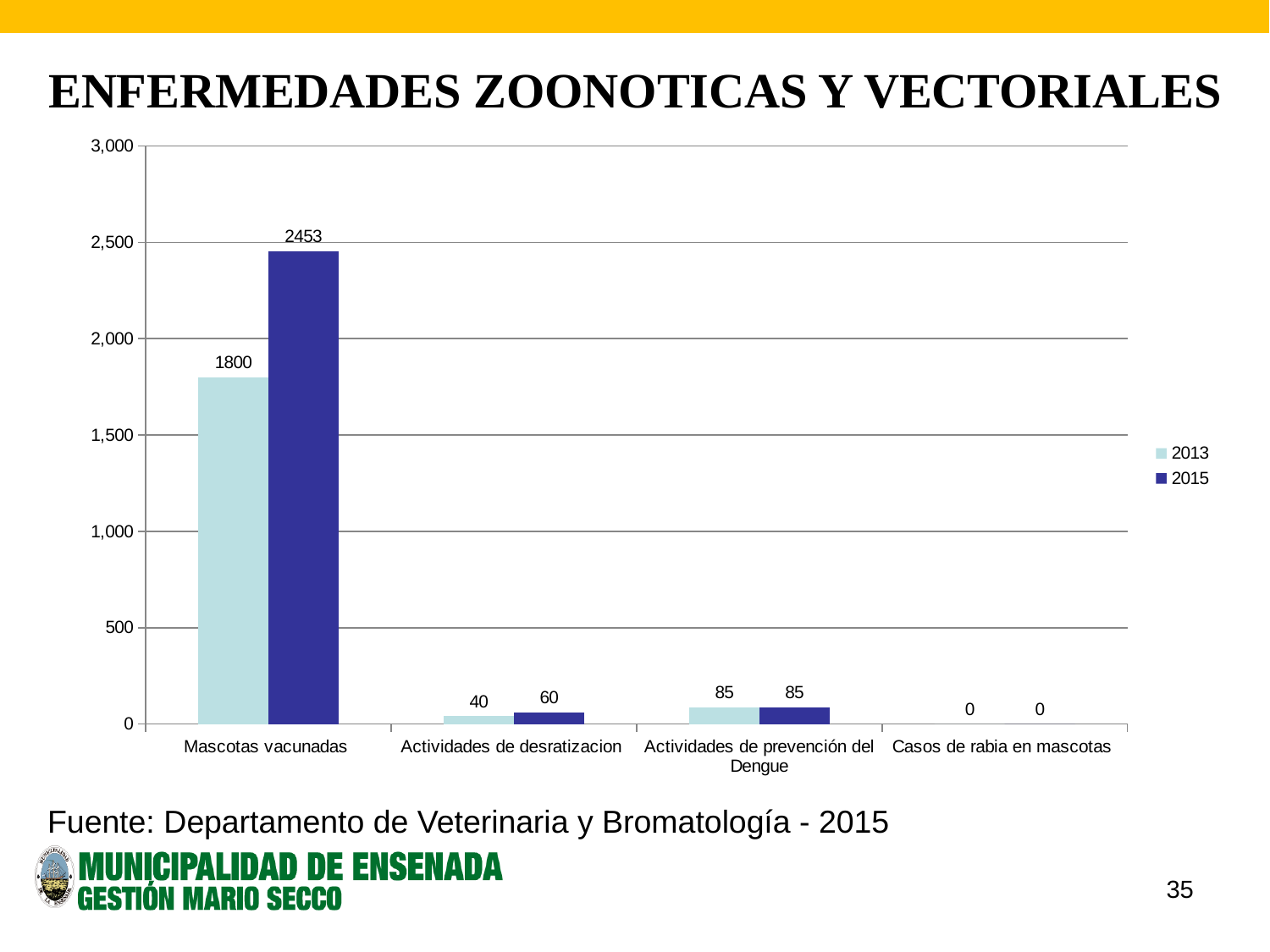
What is the value for Actividades de desratizacion in 2013? 40 What is the value for Casos de rabia en mascotas in 2015? 0 What kind of chart is shown on the slide? Bar chart What is the value for Mascotas vacunadas in 2015? 2453 What is the difference between the 2015 and 2013 values for Mascotas vacunadas? 653 How many categories are shown on the x axis? 4 What is the value for Mascotas vacunadas in 2013? 1800 Which category has the lowest value in 2013? Casos de rabia en mascotas Which category has the highest value in 2015? Mascotas vacunadas What is the value for Actividades de prevención del Dengue in 2015? 85 How many series does the legend list? 2 Which is larger for Actividades de desratizacion: the 2013 value or the 2015 value? 2015